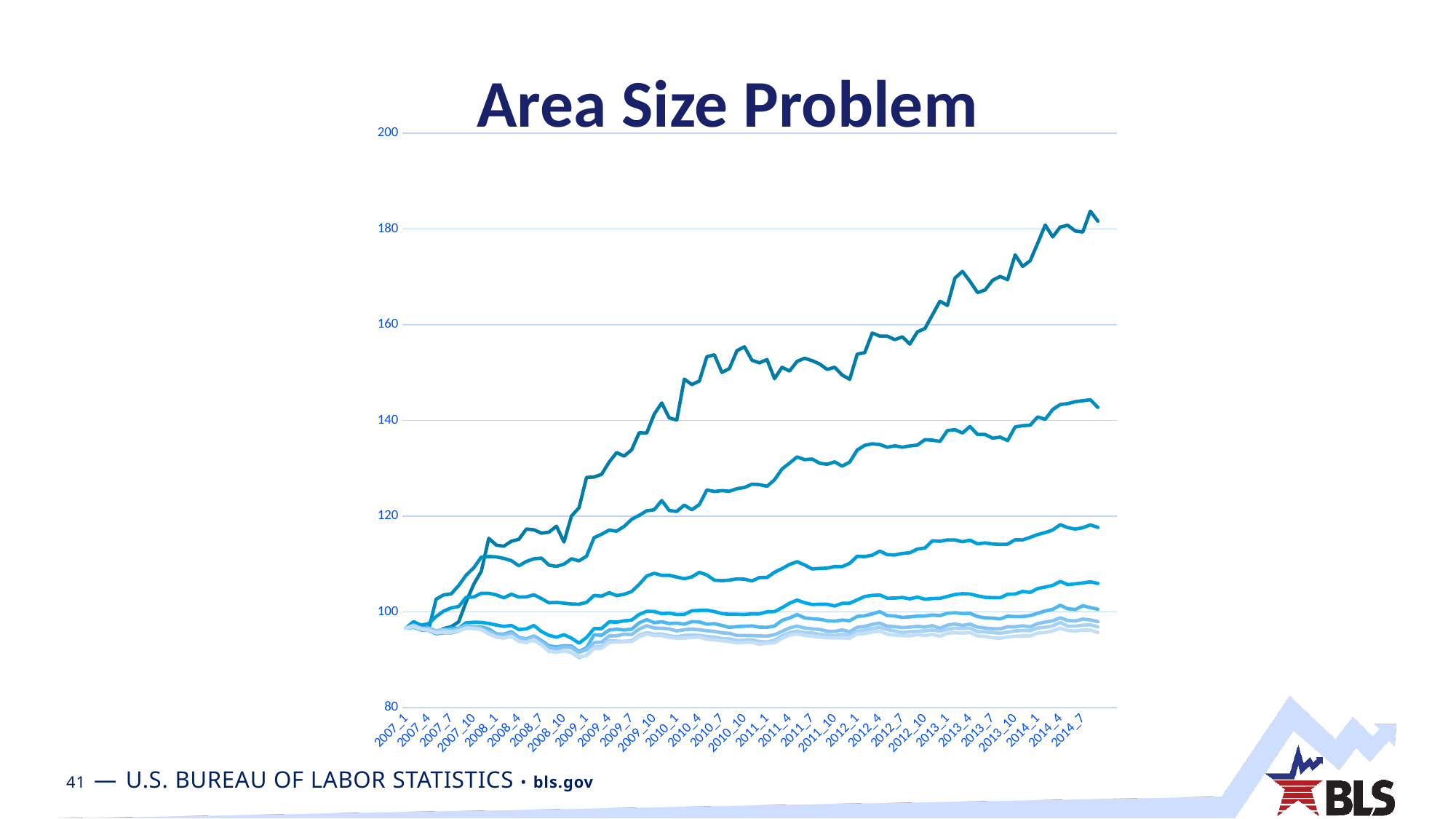
At 2014_7, is the topmost line higher or lower than the second-highest line? higher Is the value of the topmost line at 2008_1 greater or less than 120? less Is the value of the topmost line at 2010_7 greater or less than 140? greater Do all of the lines start near 100 at 2007_1, or do they start at widely different values? near 100 Is the value of the second-highest line at 2012_1 greater or less than 120? greater What kind of chart is shown on the slide? line chart What is the title of the chart? Area Size Problem What is the highest value shown on the y axis of the chart? 200 Does the topmost line rise or fall overall from 2007_1 to 2014_7? rise